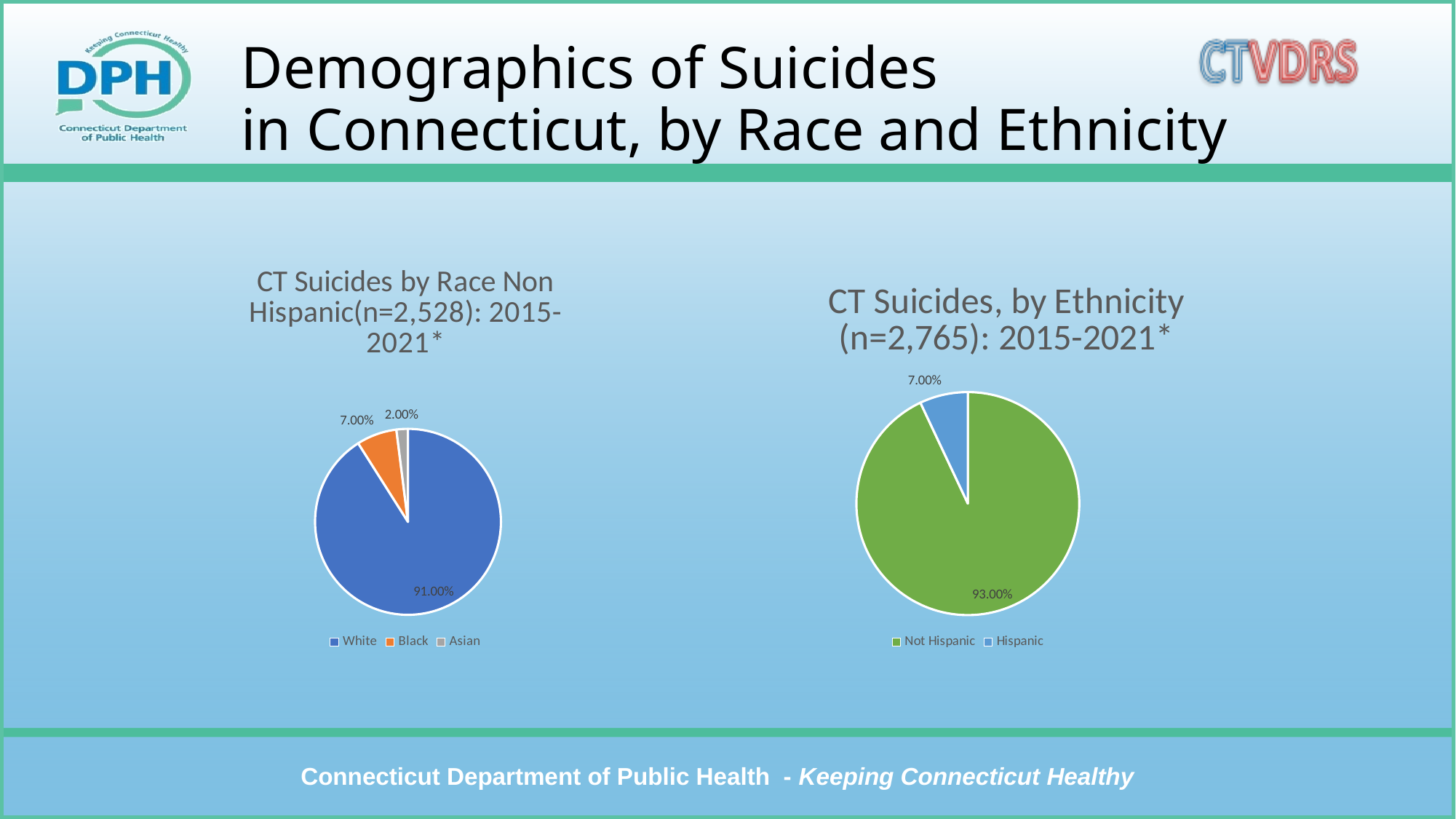
In the right pie chart (CT Suicides, by Ethnicity), what is the sample size (n) given in the title? 2,765 How many categories does the legend of the left pie chart (CT Suicides by Race Non Hispanic) list? 3 In the right pie chart (CT Suicides, by Ethnicity), what percentage is shown for Hispanic? 7.00% In the left pie chart (CT Suicides by Race Non Hispanic), which category has the largest slice? White In the left pie chart (CT Suicides by Race Non Hispanic), what percentage is shown for White? 91.00% In the right pie chart (CT Suicides, by Ethnicity), what percentage is shown for Not Hispanic? 93.00% In the left pie chart (CT Suicides by Race Non Hispanic), what is the difference in percentage points between Black and Asian? 5.00% In the left pie chart (CT Suicides by Race Non Hispanic), what percentage is shown for Asian? 2.00% What type of chart is used for CT Suicides, by Ethnicity? Pie chart In the right pie chart (CT Suicides, by Ethnicity), what is the difference in percentage points between Not Hispanic and Hispanic? 86.00% In the left pie chart (CT Suicides by Race Non Hispanic), which category has the smallest slice? Asian In the left pie chart (CT Suicides by Race Non Hispanic), what percentage is shown for Black? 7.00%